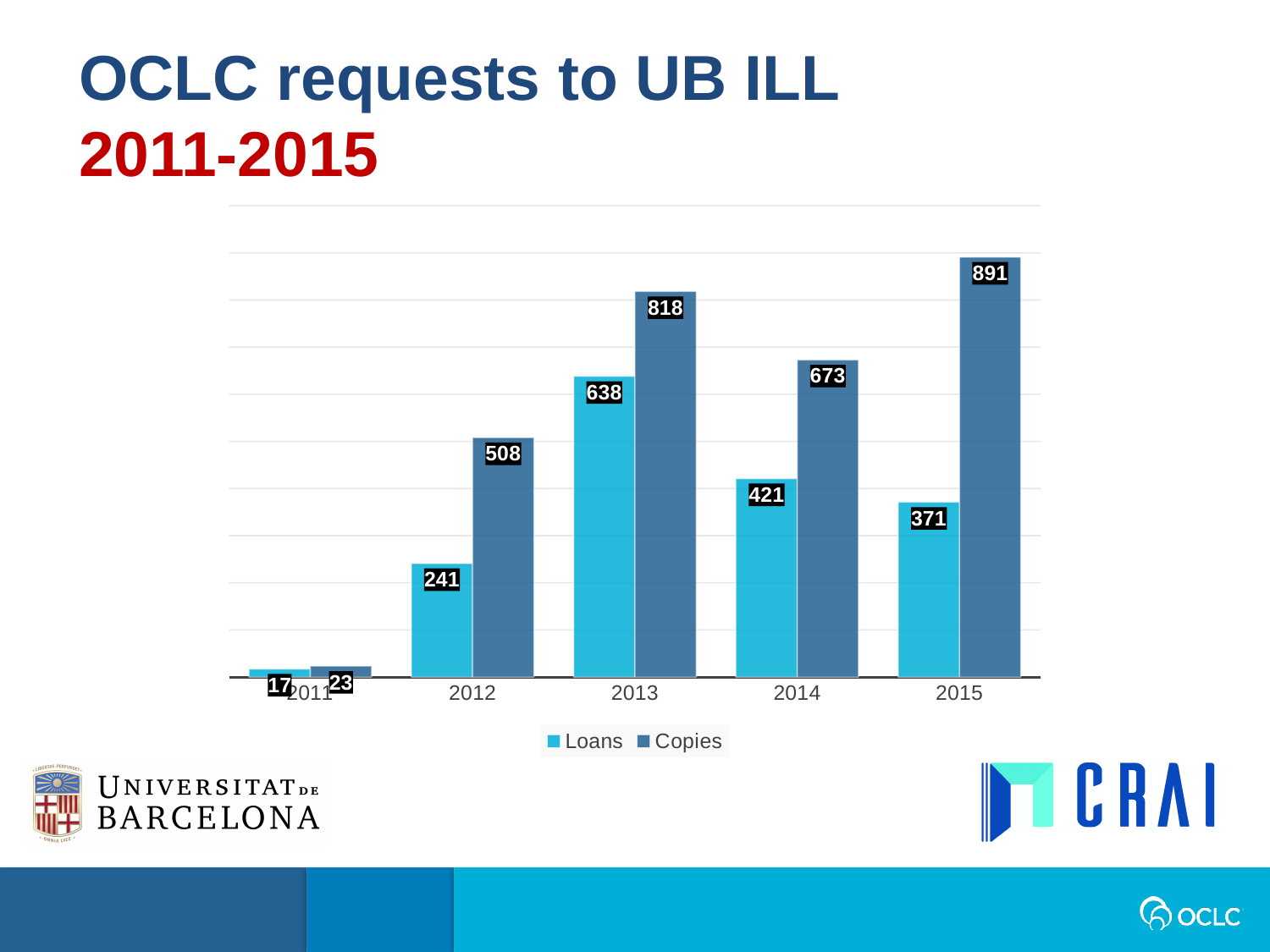
What is the value for Copies in 2015? 891 How many series does the legend list? 2 What is the difference between Copies and Loans in 2012? 267 What is the value for Loans in 2013? 638 Which year has the lowest value for Loans? 2011 What are the two series named in the legend? Loans and Copies What is the value for Loans in 2011? 17 What kind of chart is shown on the slide? Bar chart Do the Copies values rise or fall from 2011 to 2013? Rise Which is larger in 2014, Loans or Copies? Copies How many years are shown on the x axis? 5 Which year has the highest value for Copies? 2015